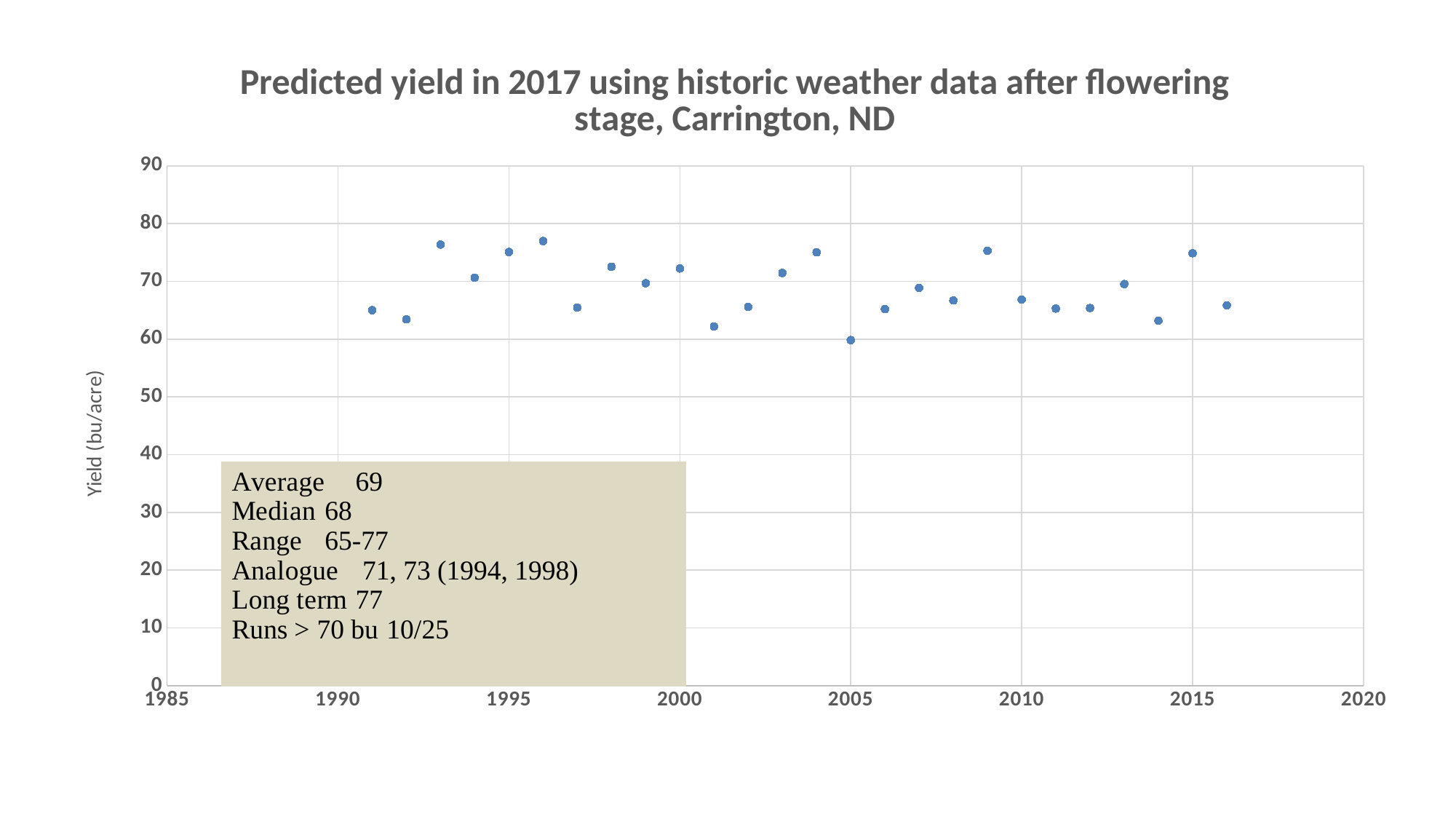
Which year has the higher predicted yield, 2001 or 2004? 2004 How many data points are plotted in the chart? 26 Is the predicted yield for 2009 greater or less than 80? less Which year has the higher predicted yield, 1996 or 2005? 1996 Is the predicted yield for 2005 greater or less than 70? less Which year has the lowest predicted yield in the chart? 2005 What is the title of the chart? Predicted yield in 2017 using historic weather data after flowering stage, Carrington, ND Is the predicted yield for 1993 greater or less than 70? greater What kind of chart is shown on the slide? scatter chart What is the label on the vertical axis of the chart? Yield (bu/acre)